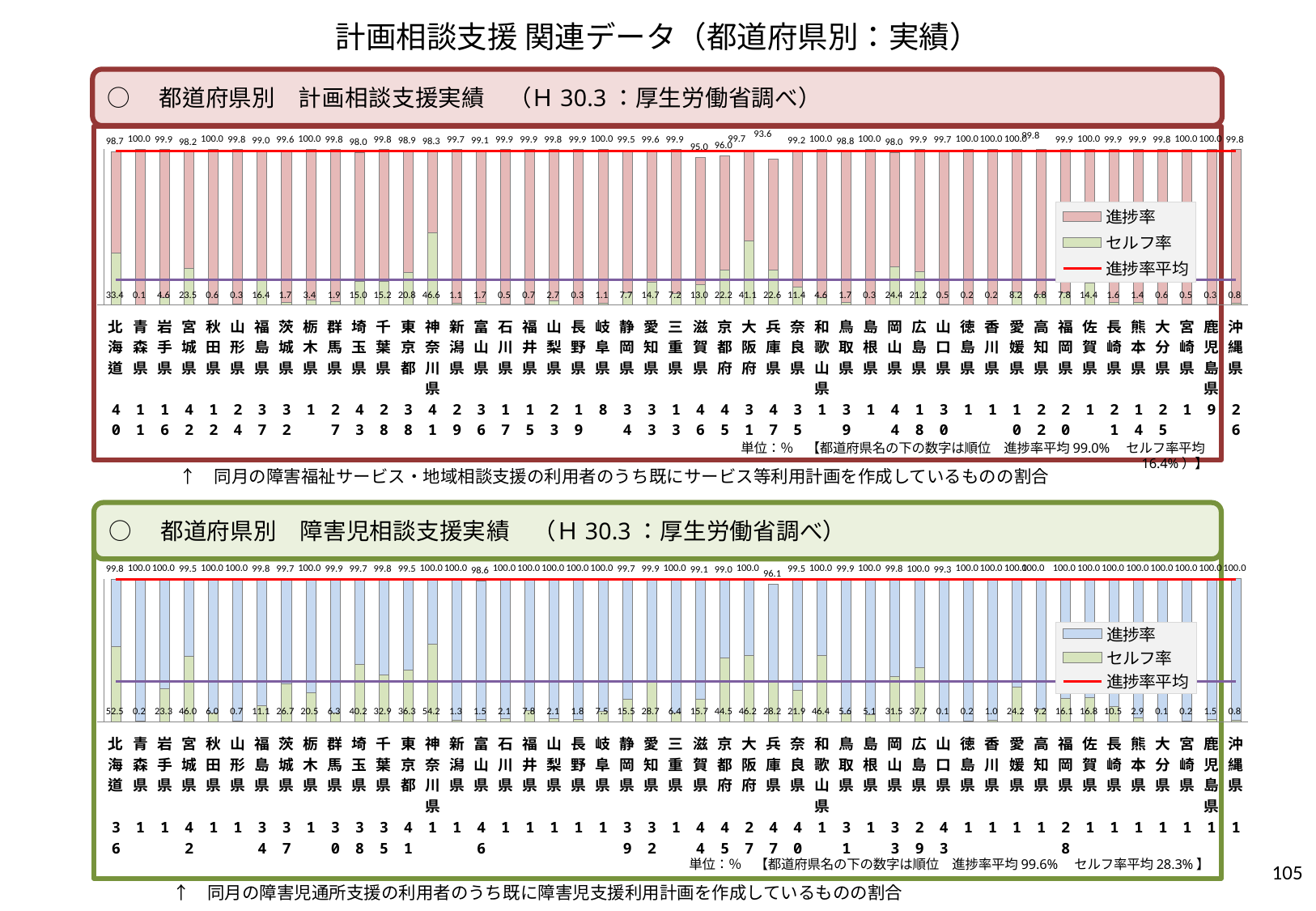
In the top chart (都道府県別 計画相談支援実績), which prefecture has the lowest 進捗率? 兵庫県 In the top chart (都道府県別 計画相談支援実績), how many series does the legend list? 3 In the top chart (都道府県別 計画相談支援実績), which prefecture has the highest セルフ率? 神奈川県 In the bottom chart (都道府県別 障害児相談支援実績), how many prefectures are plotted along the x axis? 47 In the top chart (都道府県別 計画相談支援実績), what is the 進捗率 value for 兵庫県? 93.6 In the top chart (都道府県別 計画相談支援実績), what is the difference between the セルフ率 of 大阪府 (41.1) and 京都府 (22.2)? 18.9 In the bottom chart (都道府県別 障害児相談支援実績), which prefecture has the highest セルフ率? 神奈川県 In the bottom chart (都道府県別 障害児相談支援実績), what is the セルフ率 value for 北海道? 52.5 In the bottom chart (都道府県別 障害児相談支援実績), which has the larger セルフ率, 京都府 or 大阪府? 大阪府 What kind of chart is the bottom chart (都道府県別 障害児相談支援実績)? Bar chart In the top chart (都道府県別 計画相談支援実績), what is the セルフ率 value for 神奈川県? 46.6 In the bottom chart (都道府県別 障害児相談支援実績), what is the 進捗率 value for 兵庫県? 96.1